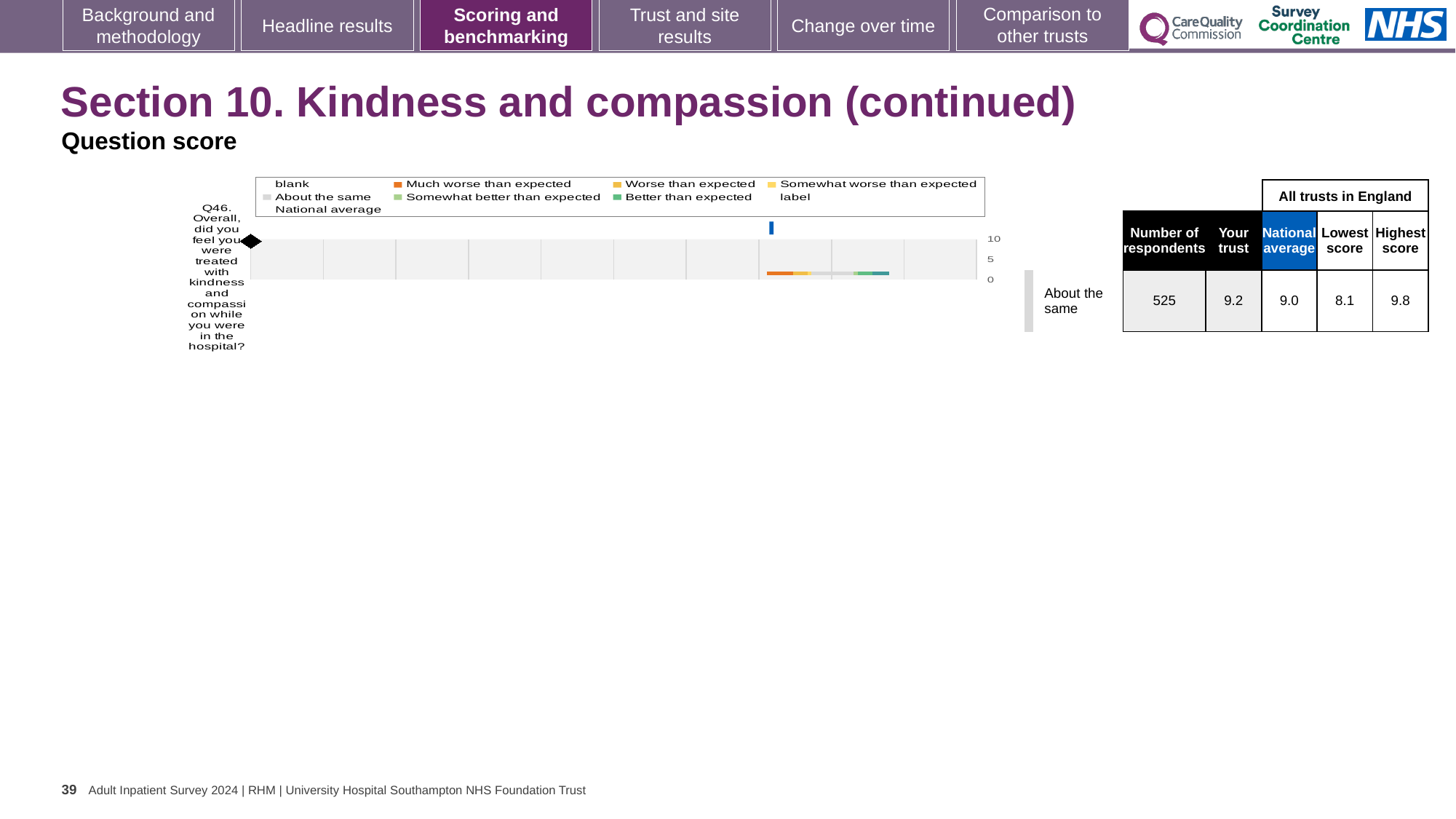
Which question is plotted on the chart? Q46. Overall, did you feel you were treated with kindness and compassion while you were in the hospital? What is the highest value shown on the chart's axis? 10 What kind of chart is shown on the slide? bar chart Which is larger for Q46, the 'Your trust' score or the national average? Your trust How many questions are plotted on the chart? 1 What is the highest score among all trusts in England for Q46? 9.8 What is the difference between the highest score and the lowest score for Q46? 1.7 What benchmark category is the trust's Q46 score placed in? About the same What is the 'Your trust' score for Q46? 9.2 What is the national average score for Q46? 9.0 How many respondents answered Q46? 525 What is the lowest score among all trusts in England for Q46? 8.1